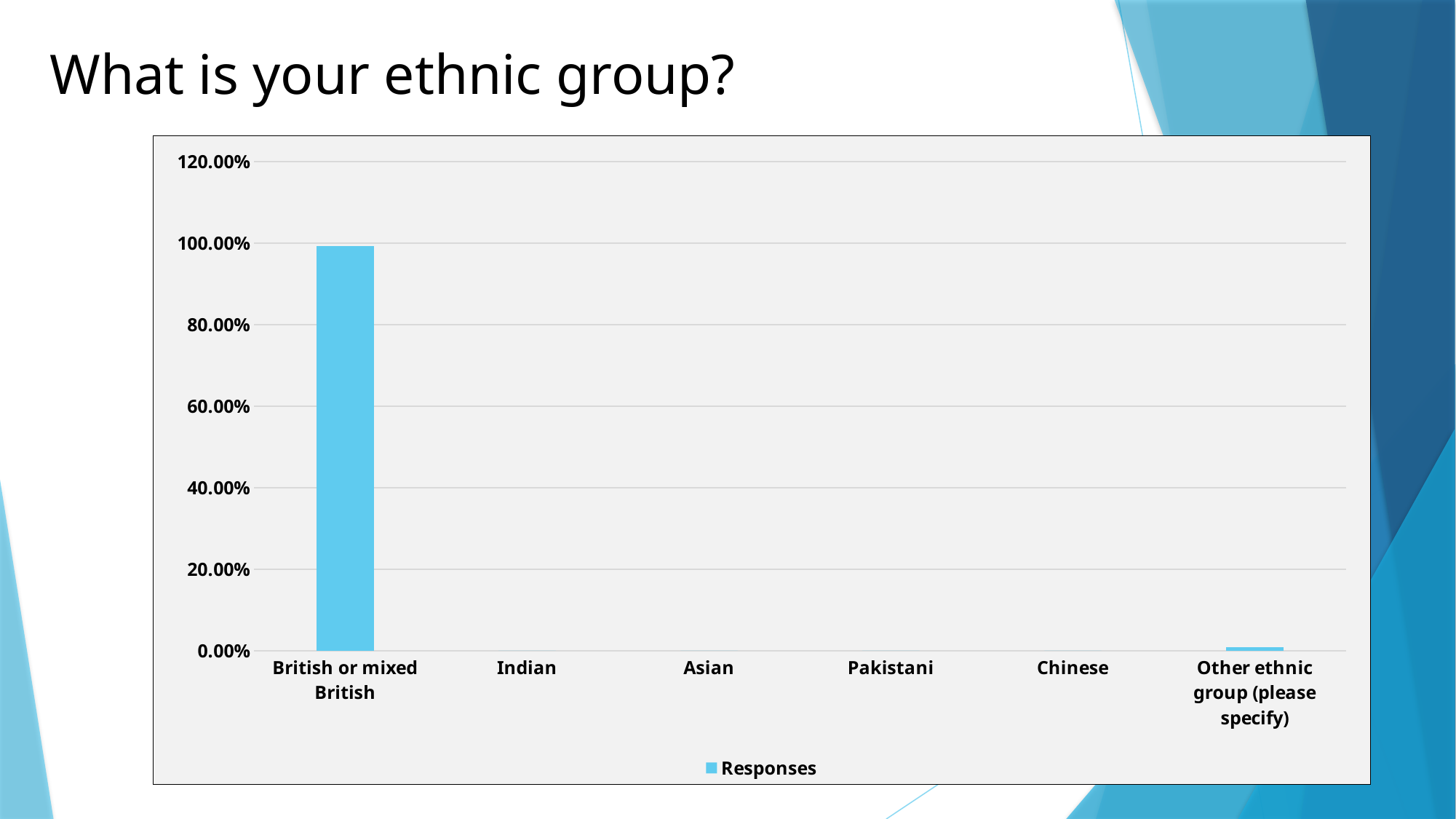
What is the name of the series shown in the legend? Responses What kind of chart is shown on the slide? bar chart How many ethnic group categories are shown on the x axis? 6 What is the title of the slide? What is your ethnic group? Is the value for British or mixed British greater or less than 60.00%? greater Which is larger, the value for British or mixed British or the value for Other ethnic group (please specify)? British or mixed British How many series does the legend list? 1 Is the value for Other ethnic group (please specify) greater or less than 20.00%? less Is the value for British or mixed British greater or less than 80.00%? greater What is the highest value shown on the y axis? 120.00% Which category has the highest bar? British or mixed British Which category has the second highest bar? Other ethnic group (please specify)